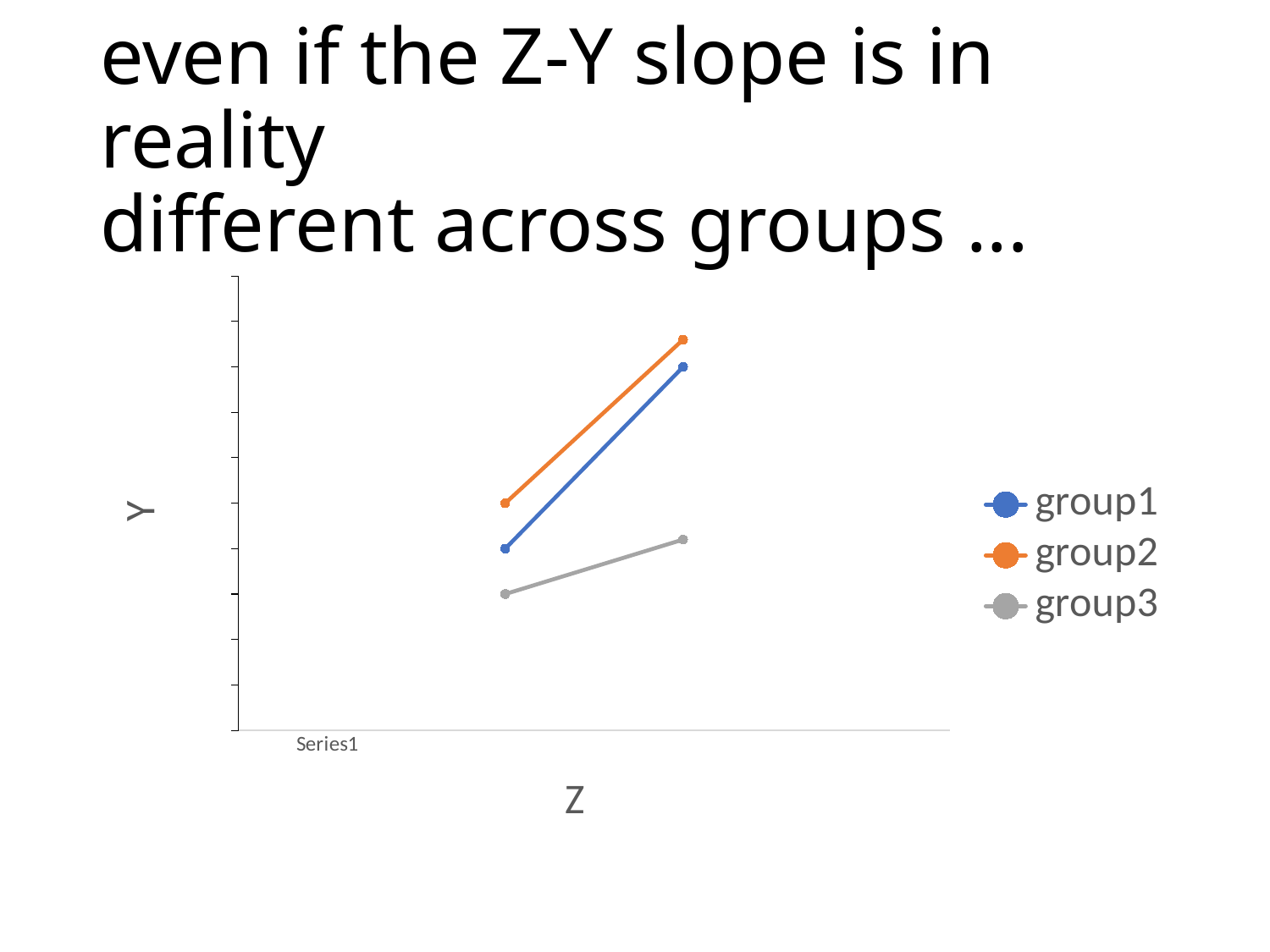
Which series has the highest value at the right-hand point? group2 What are the names of the series listed in the legend? group1, group2, group3 How many data points does each line have? 2 Which series has the lowest value at the left-hand point? group3 What kind of chart is shown on the slide? line chart Which series has the lowest value at the right-hand point? group3 How many series does the legend list? 3 Which series has the flattest slope? group3 Do the values for group3 rise or fall along the Z axis? rise At the left-hand point, which is larger: the value for group1 or the value for group2? group2 Do the values for group1 rise or fall along the Z axis? rise What is the label on the vertical axis? Y